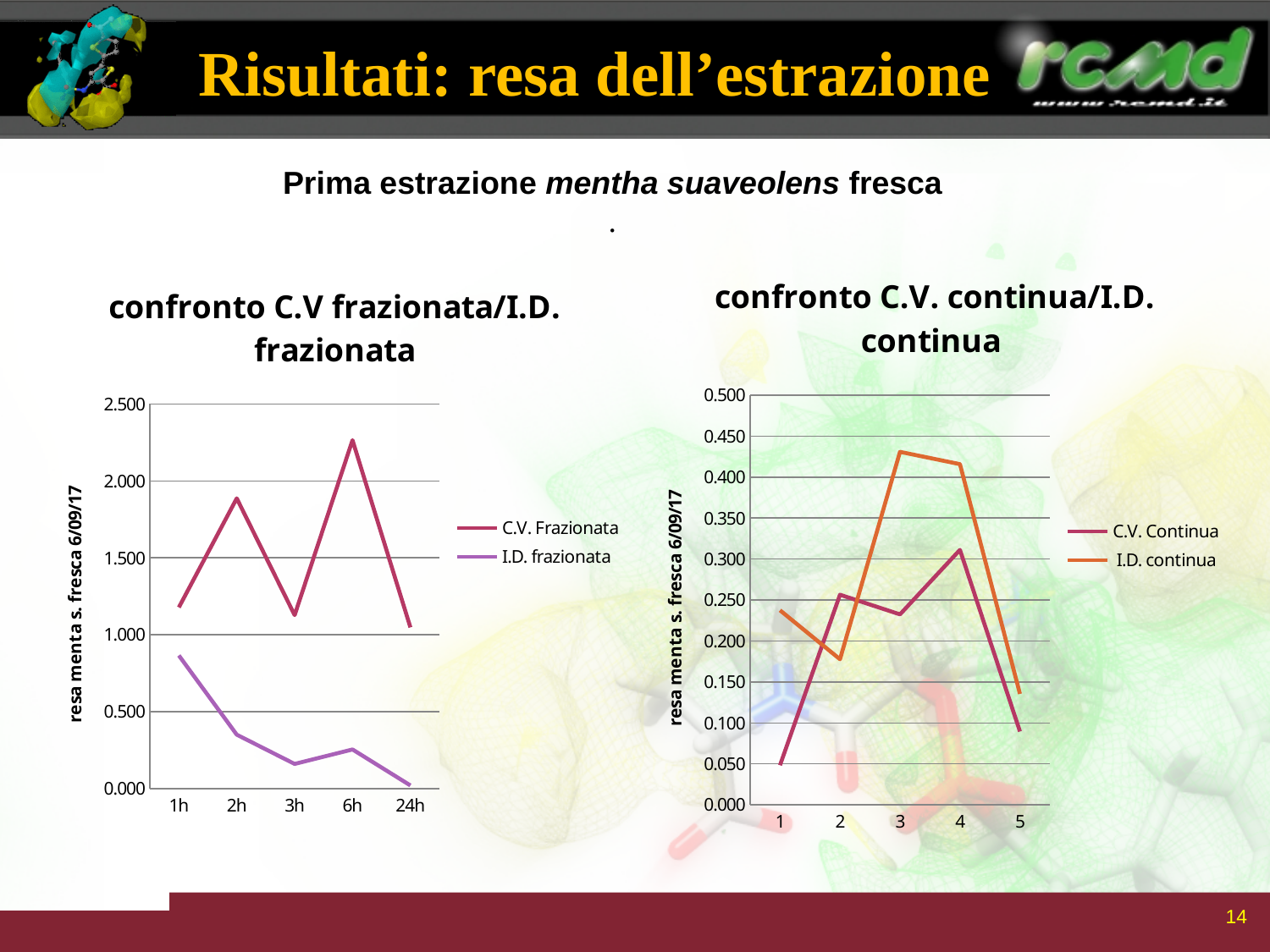
In the chart titled 'confronto C.V frazionata/I.D. frazionata', how many series does the legend list? 2 In the chart titled 'confronto C.V frazionata/I.D. frazionata', at which category does C.V. Frazionata reach its highest value? 6h In the chart titled 'confronto C.V. continua/I.D. continua', what is the label of the y axis? resa menta s. fresca 6/09/17 In the chart titled 'confronto C.V frazionata/I.D. frazionata', at which category is I.D. frazionata lowest? 24h In the chart titled 'confronto C.V. continua/I.D. continua', at which category is C.V. Continua lowest? 1 In the chart titled 'confronto C.V. continua/I.D. continua', is the value of I.D. continua at category 3 greater or less than 0.400? greater In the chart titled 'confronto C.V frazionata/I.D. frazionata', which series has the higher value at 2h, C.V. Frazionata or I.D. frazionata? C.V. Frazionata In the chart titled 'confronto C.V frazionata/I.D. frazionata', is the value of C.V. Frazionata at 6h greater or less than 2.000? greater In the chart titled 'confronto C.V frazionata/I.D. frazionata', does I.D. frazionata generally rise or fall from 1h to 24h? fall In the chart titled 'confronto C.V. continua/I.D. continua', at which category does I.D. continua reach its highest value? 3 In the chart titled 'confronto C.V frazionata/I.D. frazionata', how many categories are on the x axis? 5 In the chart titled 'confronto C.V frazionata/I.D. frazionata', what kind of chart is shown? line chart